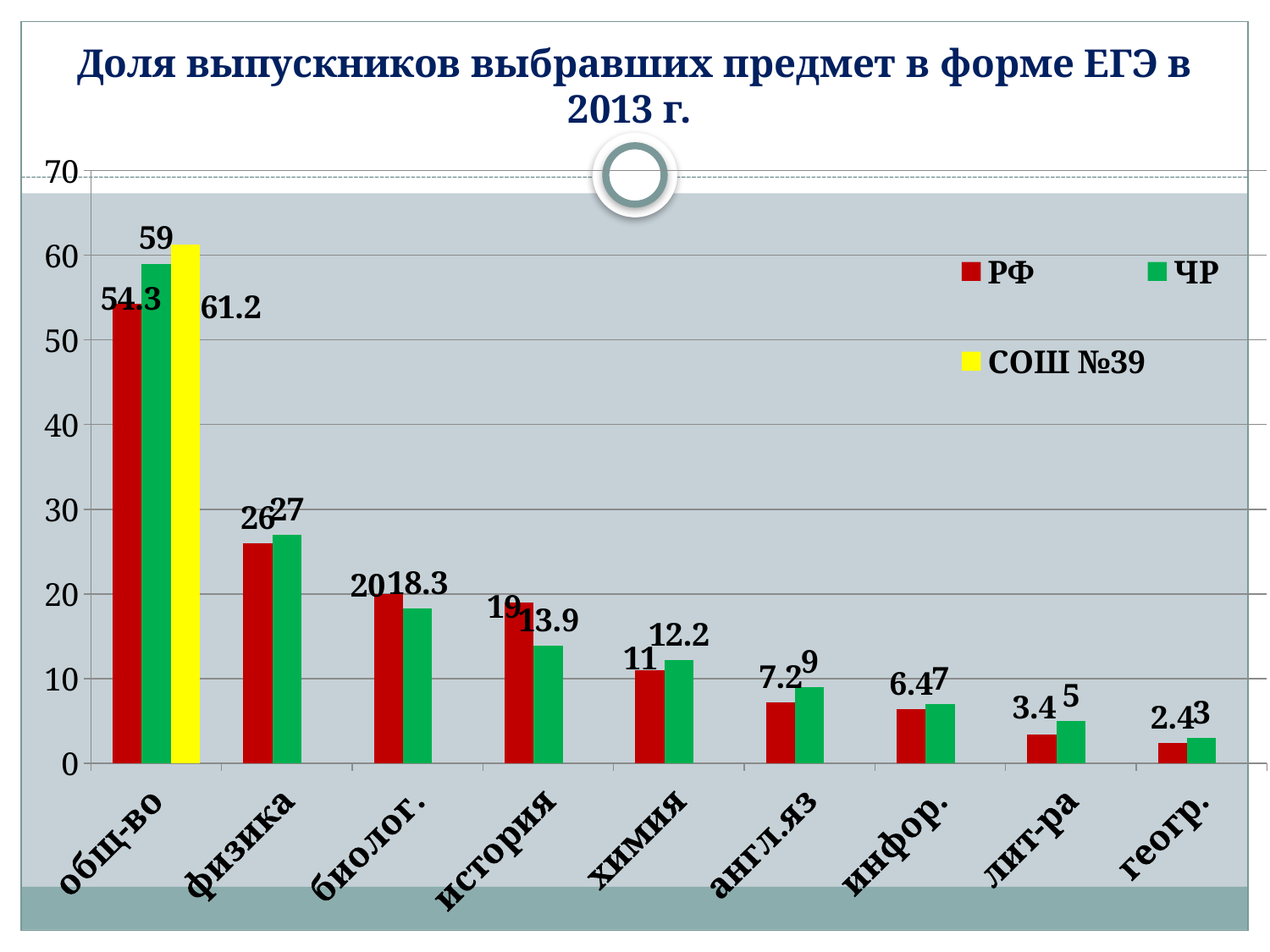
What is the РФ value for история? 19 How many series does the legend list? 3 What is the difference between the ЧР and РФ values for общ-во? 4.7 Which series is shown in yellow in the legend? СОШ №39 Which category has the lowest ЧР value? геогр. What type of chart is shown on the slide? bar chart For химия, which is larger: the РФ value or the ЧР value? ЧР What is the value for СОШ №39 in the общ-во category? 61.2 What is the ЧР value for биолог.? 18.3 Is the РФ value for физика greater or less than 30? less How many subject categories are shown on the x axis? 9 Which category has the highest РФ value? общ-во